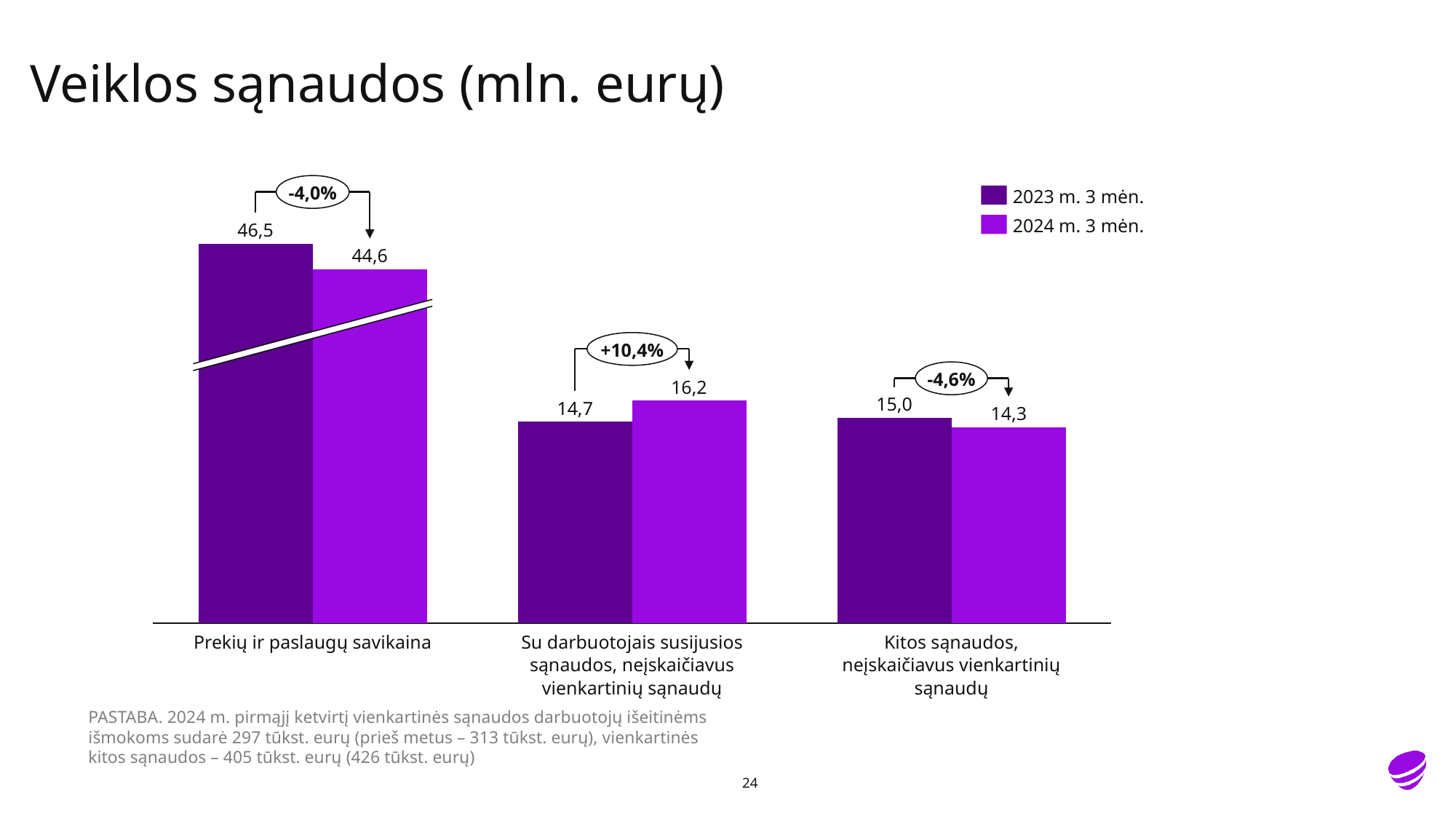
What is the title of the chart? Veiklos sąnaudos (mln. eurų) What is the value for Kitos sąnaudos, neįskaičiavus vienkartinių sąnaudų in 2024 m. 3 mėn.? 14,3 What is the difference between the 2023 m. 3 mėn. and 2024 m. 3 mėn. values for Prekių ir paslaugų savikaina? 1,9 What percentage change is shown above the Su darbuotojais susijusios sąnaudos, neįskaičiavus vienkartinių sąnaudų bars? +10,4% How many categories are shown on the x axis? 3 How many series does the legend list? 2 What is the value for Su darbuotojais susijusios sąnaudos, neįskaičiavus vienkartinių sąnaudų in 2024 m. 3 mėn.? 16,2 What kind of chart is shown on the slide? Bar chart Which category has the lowest value in 2023 m. 3 mėn.? Su darbuotojais susijusios sąnaudos, neįskaičiavus vienkartinių sąnaudų What is the value for Prekių ir paslaugų savikaina in 2023 m. 3 mėn.? 46,5 Which category has the highest value in 2024 m. 3 mėn.? Prekių ir paslaugų savikaina Which is larger for Su darbuotojais susijusios sąnaudos, neįskaičiavus vienkartinių sąnaudų: the 2023 m. 3 mėn. value or the 2024 m. 3 mėn. value? 2024 m. 3 mėn.